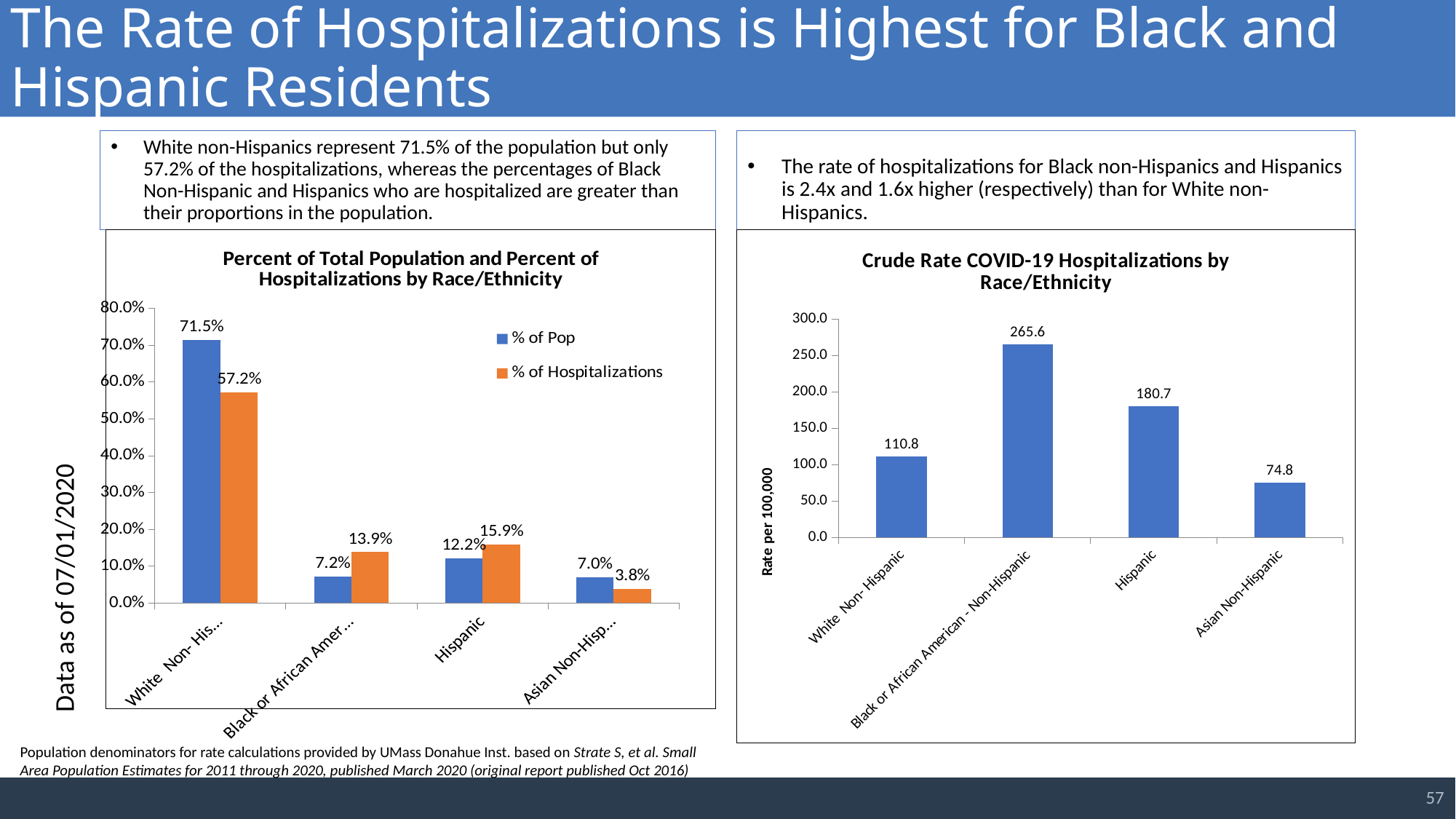
In the chart titled 'Percent of Total Population and Percent of Hospitalizations by Race/Ethnicity', what is the % of Hospitalizations for Hispanic residents? 15.9% In the chart titled 'Crude Rate COVID-19 Hospitalizations by Race/Ethnicity', what is the difference between the rates for Black or African American - Non-Hispanic and White Non-Hispanic residents? 154.8 In the chart titled 'Percent of Total Population and Percent of Hospitalizations by Race/Ethnicity', what is the difference between the % of Pop and % of Hospitalizations for White Non-Hispanic residents? 14.3% In the chart titled 'Crude Rate COVID-19 Hospitalizations by Race/Ethnicity', how many groups are shown? 4 In the chart titled 'Crude Rate COVID-19 Hospitalizations by Race/Ethnicity', which group has the lowest rate? Asian Non-Hispanic In the chart titled 'Crude Rate COVID-19 Hospitalizations by Race/Ethnicity', what is the label of the vertical axis? Rate per 100,000 In the chart titled 'Percent of Total Population and Percent of Hospitalizations by Race/Ethnicity', what is the % of Pop for Hispanic residents? 12.2% In the chart titled 'Percent of Total Population and Percent of Hospitalizations by Race/Ethnicity', which is larger for Hispanic residents: % of Pop or % of Hospitalizations? % of Hospitalizations In the chart titled 'Crude Rate COVID-19 Hospitalizations by Race/Ethnicity', which group has the highest rate? Black or African American - Non-Hispanic In the chart titled 'Percent of Total Population and Percent of Hospitalizations by Race/Ethnicity', how many series does the legend list? 2 In the chart titled 'Crude Rate COVID-19 Hospitalizations by Race/Ethnicity', what is the rate for Hispanic residents? 180.7 What kind of chart is the chart titled 'Crude Rate COVID-19 Hospitalizations by Race/Ethnicity'? Bar chart